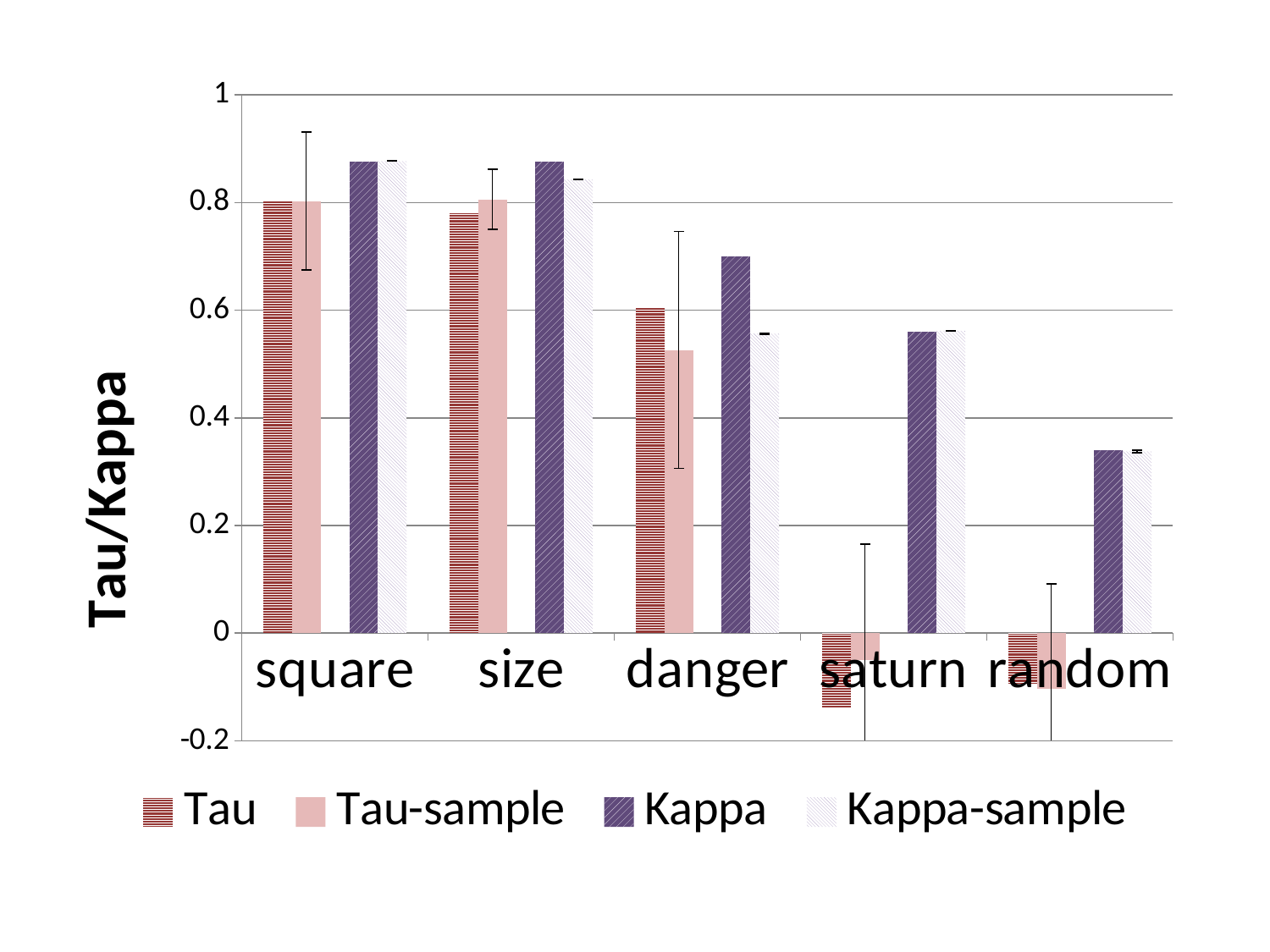
How many series does the legend list? 4 Is the Tau value for square greater or less than 0.6? greater Which is larger, the Kappa value for danger or the Kappa value for saturn? danger Do the Kappa values generally rise or fall going from square to random along the x axis? fall Which series are listed in the legend? Tau, Tau-sample, Kappa, Kappa-sample Is the Kappa value for danger greater or less than 0.6? greater What is the label of the vertical axis? Tau/Kappa How many categories are shown on the x axis? 5 Which category has the lowest Kappa value? random Is the Kappa value for random greater or less than 0.4? less Which category has the lowest Tau value? saturn What kind of chart is shown on the slide? bar chart